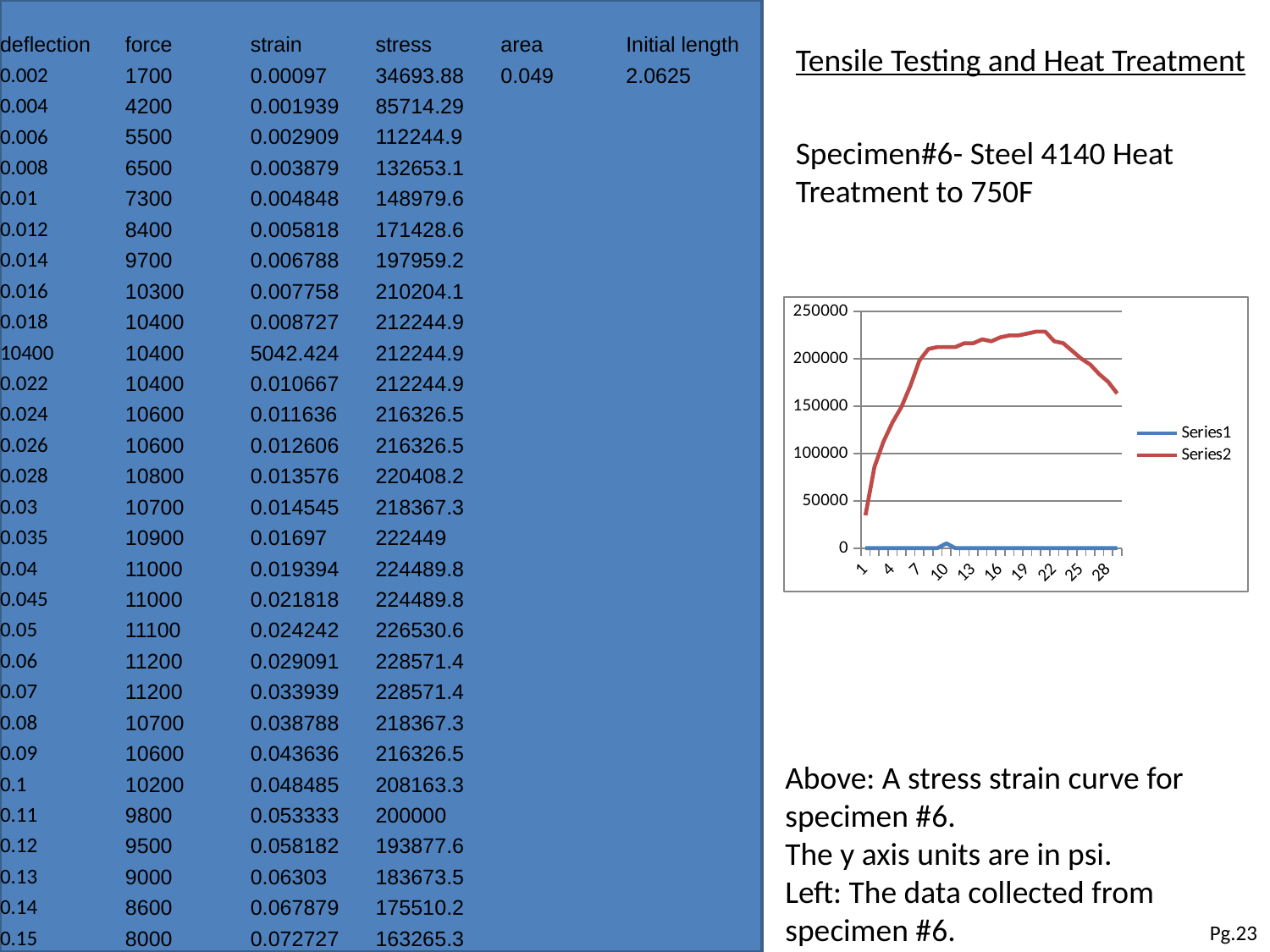
Does Series2 rise or fall between x = 1 and x = 7? rise Is the peak value of Series2 greater or less than 200000? greater Is the value of Series1 at x = 16 greater or less than 50000? less Is the value of Series2 at x = 28 greater or less than 150000? greater Does Series2 rise or fall between x = 22 and x = 28? fall Which series reaches higher values on the chart, Series1 or Series2? Series2 What kind of chart is shown on the slide? line chart Which series stays close to zero across the whole chart? Series1 How many series does the chart legend list? 2 What is the highest value labelled on the chart's y axis? 250000 What are the names of the series in the chart legend? Series1 and Series2